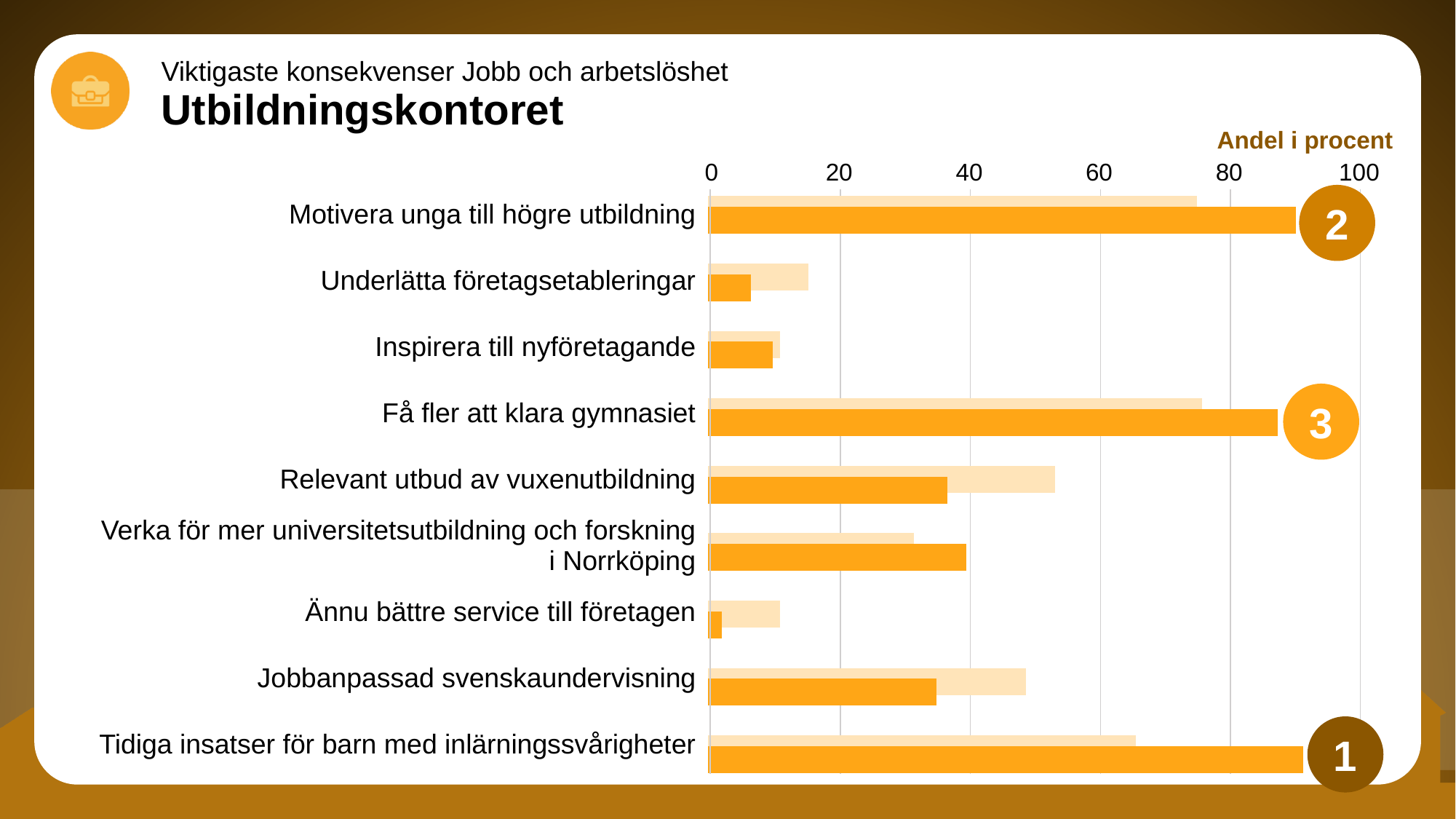
Which category has the lowest value for the dark orange bar? Ännu bättre service till företagen Which has the larger light orange bar: 'Tidiga insatser för barn med inlärningssvårigheter' or 'Relevant utbud av vuxenutbildning'? Tidiga insatser för barn med inlärningssvårigheter Is the dark orange bar for 'Verka för mer universitetsutbildning och forskning i Norrköping' greater or less than 20? greater Is the dark orange bar for 'Underlätta företagsetableringar' greater or less than 20? less Is the light orange bar for 'Tidiga insatser för barn med inlärningssvårigheter' greater or less than 60? greater What label is shown above the horizontal axis of the chart? Andel i procent How many categories are listed on the chart? 9 What kind of chart is shown on the slide? bar chart What is the highest value shown on the horizontal axis? 100 Which has the larger dark orange bar: 'Verka för mer universitetsutbildning och forskning i Norrköping' or 'Jobbanpassad svenskaundervisning'? Verka för mer universitetsutbildning och forskning i Norrköping